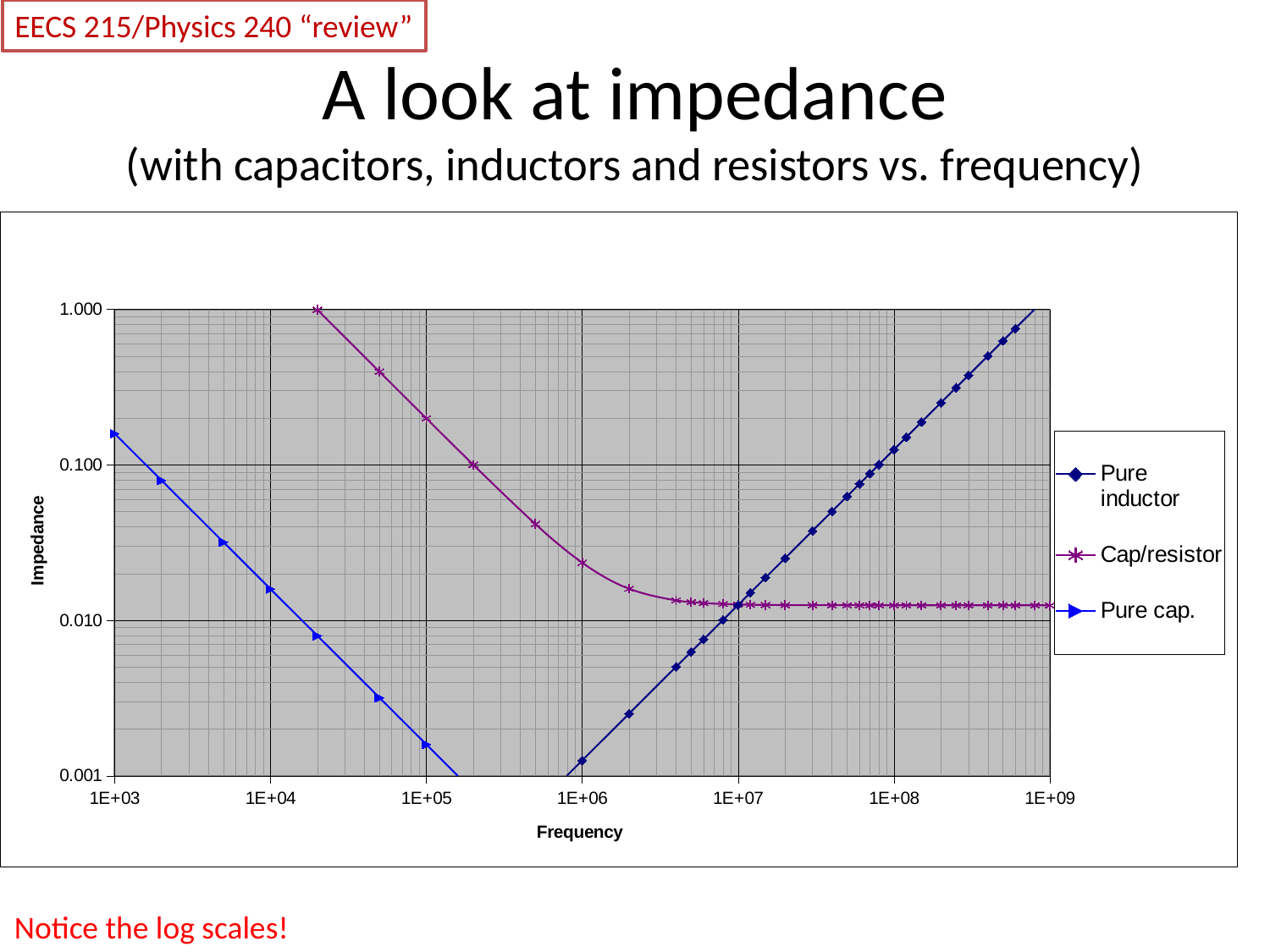
Is the Cap/resistor impedance at a frequency of 1E+09 greater or less than 0.100? less Is the Cap/resistor impedance at a frequency of 1E+09 greater or less than 0.010? greater At a frequency of 1E+04, which series has the higher impedance, Pure cap. or Cap/resistor? Cap/resistor Is the Pure cap. impedance at a frequency of 1E+04 greater or less than 0.010? greater Does the Pure inductor series rise or fall as frequency increases? rise What is the title of the chart's x axis? Frequency Does the Pure cap. series rise or fall as frequency increases? fall What kind of chart is shown on the slide? line chart What are the three series named in the legend? Pure inductor, Cap/resistor, Pure cap. At a frequency of 1E+08, which series has the higher impedance, Pure inductor or Cap/resistor? Pure inductor How many series does the chart's legend list? 3